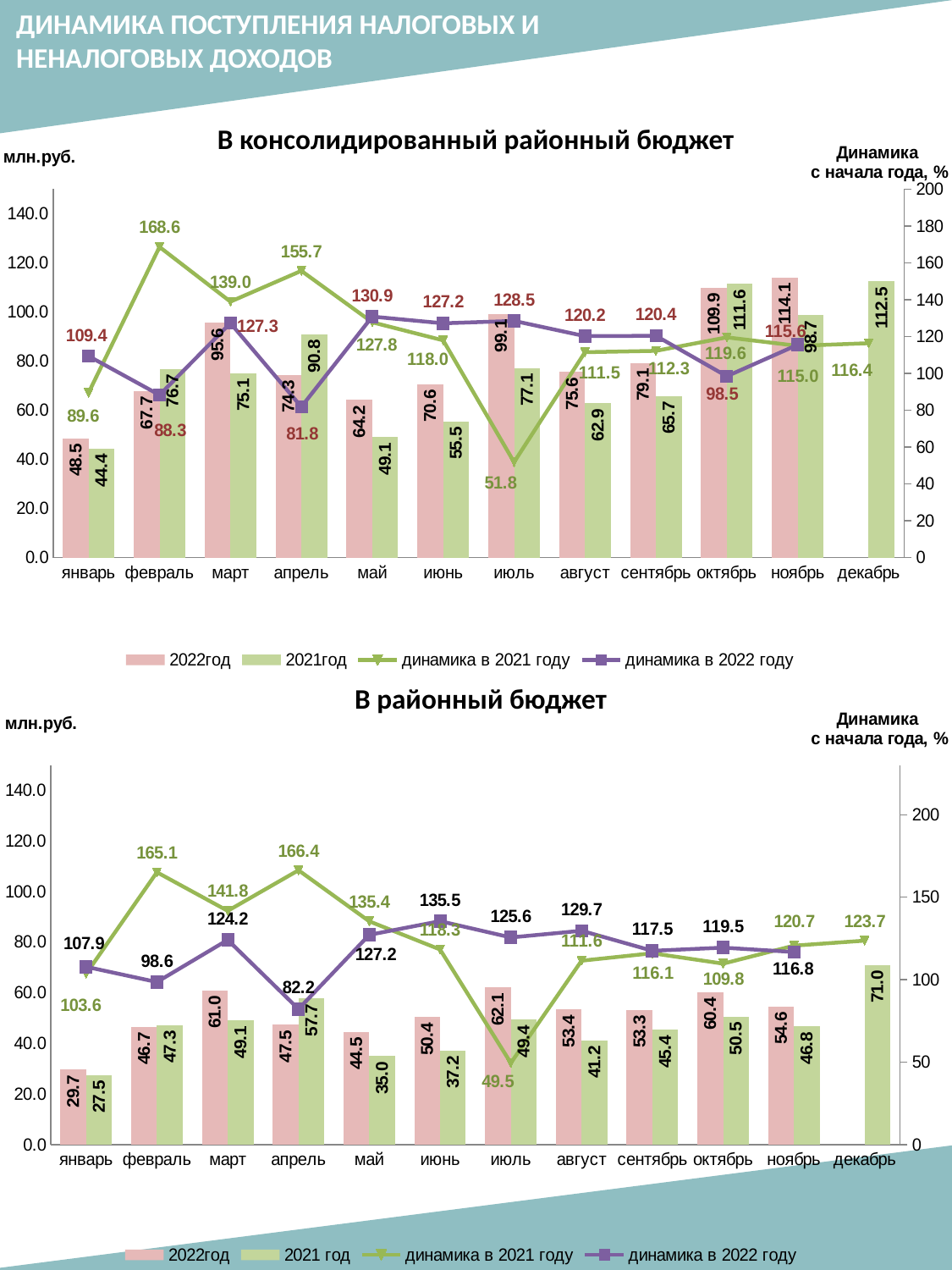
In the chart 'В районный бюджет', which month has the lowest 2021год value? январь In the chart 'В районный бюджет', what is the value of the 2022год series for октябрь? 60.4 In the chart 'В консолидированный районный бюджет', what is the value of the 2021год series for декабрь? 112.5 In the chart 'В консолидированный районный бюджет', how many series does the legend list? 4 In the chart 'В консолидированный районный бюджет', which month has the highest value of the 'динамика в 2021 году' line? февраль In the chart 'В районный бюджет', which is larger for апрель: the 2022год value or the 2021год value? 2021год What kind of chart is 'В районный бюджет'? Combined bar and line chart In the chart 'В консолидированный районный бюджет', what is the difference between the 2022год and 2021год values for июль? 22.0 In the chart 'В районный бюджет', what is the value of the 'динамика в 2022 году' line for июнь? 135.5 In the chart 'В консолидированный районный бюджет', which month has the lowest value of the 'динамика в 2021 году' line? июль In the chart 'В районный бюджет', how many months are shown on the x axis? 12 In the chart 'В консолидированный районный бюджет', what is the value of the 2022год series for март? 95.6